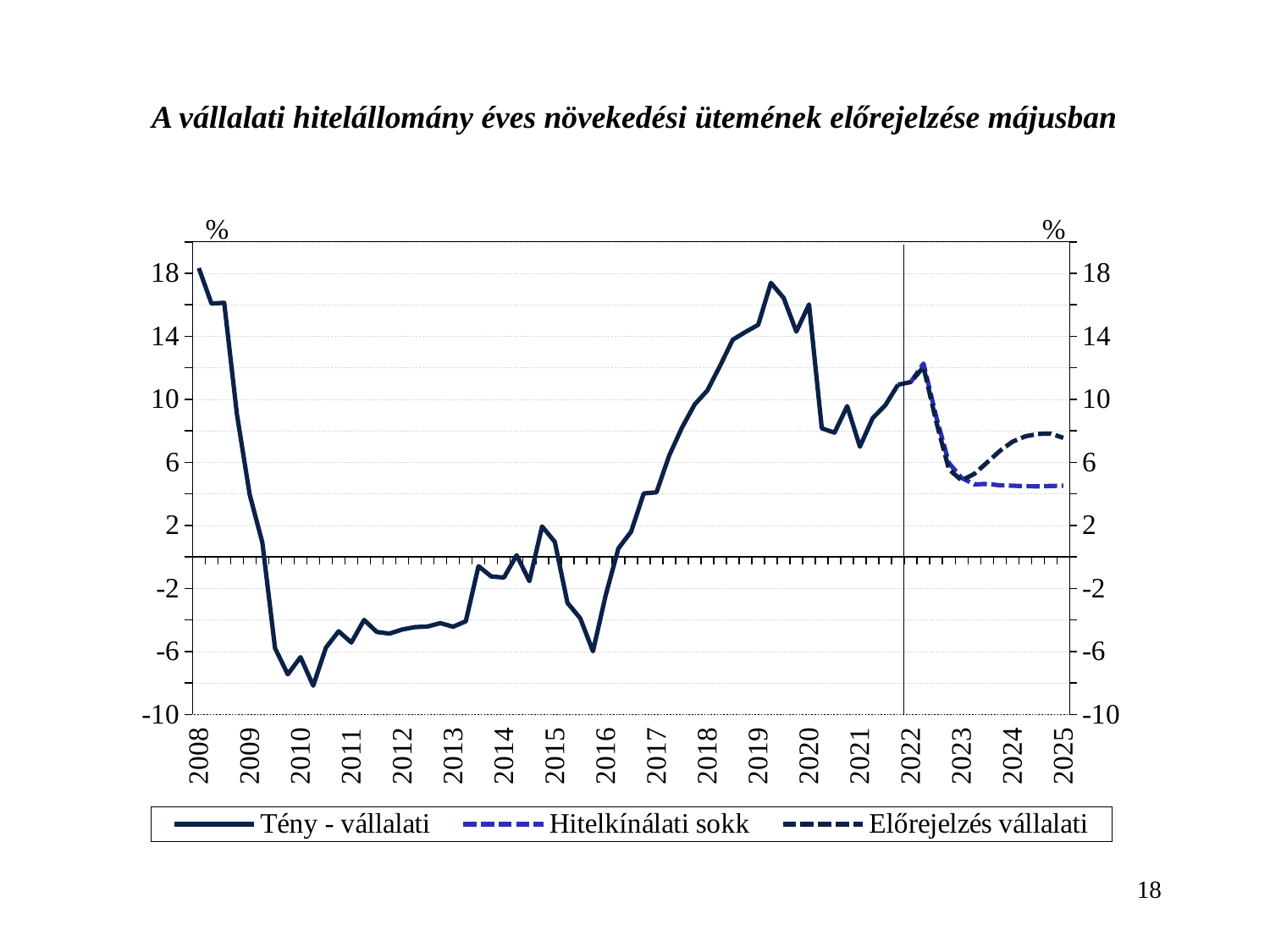
Is the value of the Tény - vállalati line at the start of 2008 greater or less than 14? greater What kind of chart is shown on the slide? line chart What unit is shown on the vertical axes of the chart? % In which year does the Tény - vállalati line reach its lowest value? 2010 Is the value of the Tény - vállalati line in 2010 greater or less than -2? less Is the value of the Előrejelzés vállalati line at 2025 greater or less than 6? greater Does the Tény - vállalati line rise or fall between 2008 and 2010? fall How many series does the legend list? 3 At 2025, which line is higher: Előrejelzés vállalati or Hitelkínálati sokk? Előrejelzés vállalati What are the three series named in the legend? Tény - vállalati, Hitelkínálati sokk, Előrejelzés vállalati